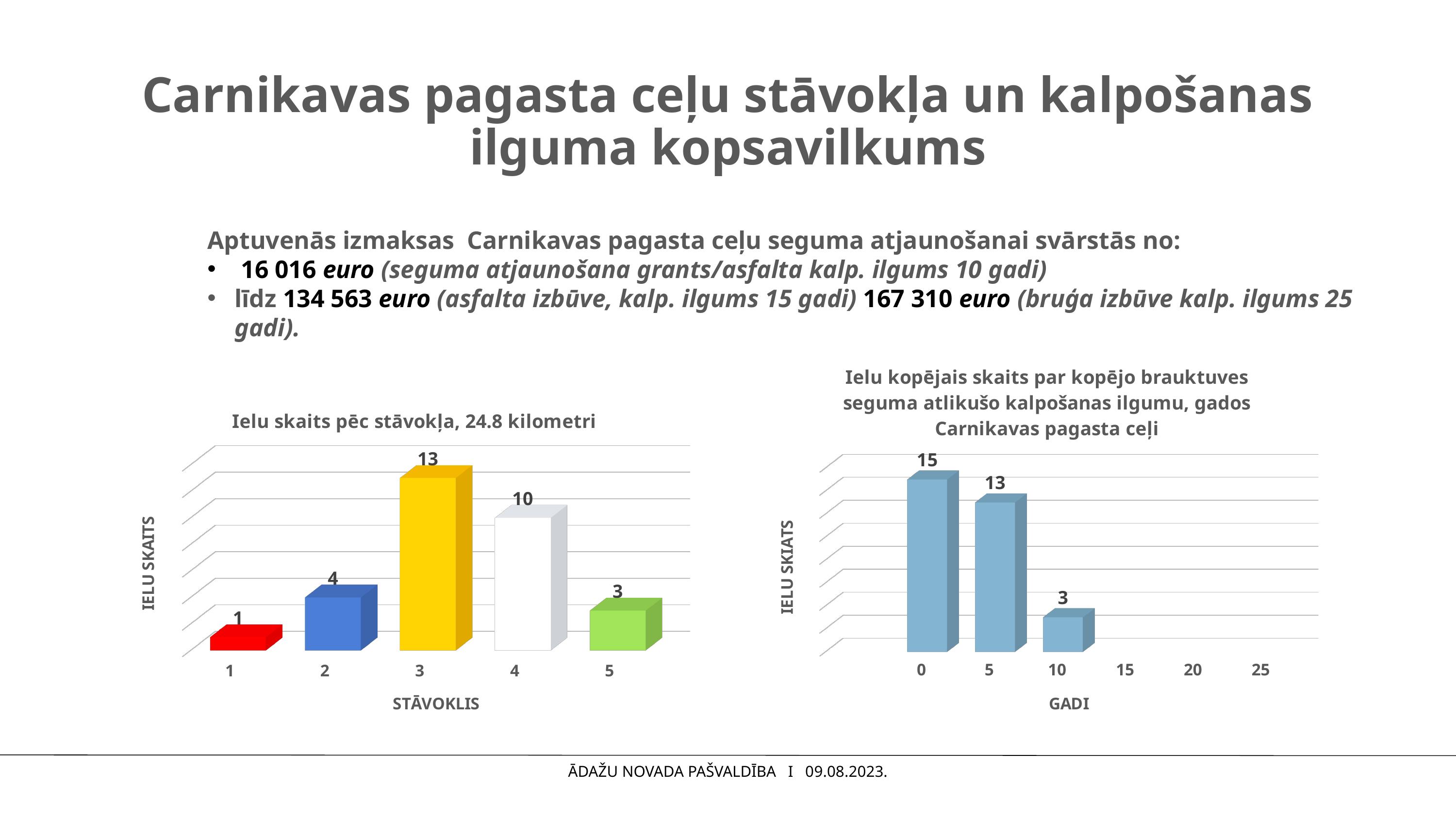
What kind of chart is the left chart, 'Ielu skaits pēc stāvokļa, 24.8 kilometri'? bar chart In the chart 'Ielu skaits pēc stāvokļa, 24.8 kilometri', which is larger: the value for stāvoklis 2 or stāvoklis 5? stāvoklis 2 In the right chart ('Ielu kopējais skaits par kopējo brauktuves seguma atlikušo kalpošanas ilgumu, gados'), what is the value for 0 gadi? 15 In the chart 'Ielu skaits pēc stāvokļa, 24.8 kilometri', what is the value for stāvoklis 4? 10 In the chart 'Ielu skaits pēc stāvokļa, 24.8 kilometri', how many stāvoklis categories are shown on the x axis? 5 In the chart 'Ielu skaits pēc stāvokļa, 24.8 kilometri', what is the value for stāvoklis 3? 13 In the chart 'Ielu skaits pēc stāvokļa, 24.8 kilometri', which stāvoklis category has the highest value? 3 In the chart 'Ielu skaits pēc stāvokļa, 24.8 kilometri', what is the difference between the values for stāvoklis 3 and stāvoklis 4? 3 In the chart 'Ielu skaits pēc stāvokļa, 24.8 kilometri', which stāvoklis category has the lowest value? 1 In the right chart ('Ielu kopējais skaits par kopējo brauktuves seguma atlikušo kalpošanas ilgumu, gados'), do the bar values rise or fall as gadi increases from 0 to 10? fall In the right chart ('Ielu kopējais skaits par kopējo brauktuves seguma atlikušo kalpošanas ilgumu, gados'), what is the value for 10 gadi? 3 In the right chart ('Ielu kopējais skaits par kopējo brauktuves seguma atlikušo kalpošanas ilgumu, gados'), what is the difference between the values for 0 gadi and 5 gadi? 2